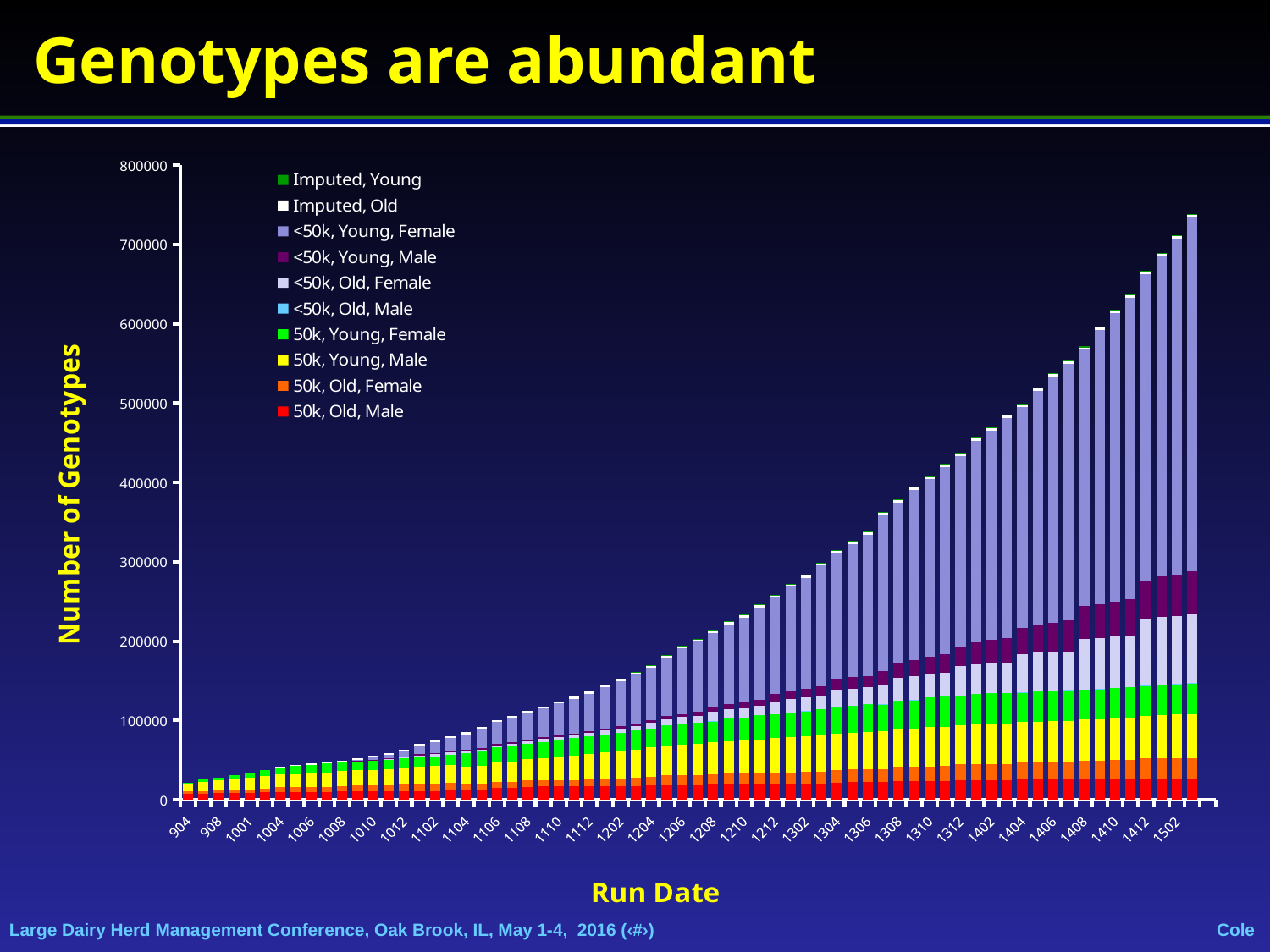
What is the title of the y axis? Number of Genotypes Which run date has the lowest total number of genotypes? 904 What is the title of the x axis? Run Date Is the total number of genotypes for run date 1102 greater or less than 100000? less Is the total number of genotypes for run date 1210 greater or less than 200000? greater Is the total number of genotypes for run date 1502 greater or less than 700000? greater Which run date has a larger total number of genotypes, 1306 or 1206? 1306 Do the total number of genotypes rise or fall as the run date moves from 904 to 1502? Rise What kind of chart is shown on the slide? Stacked bar chart How many series does the legend list? 10